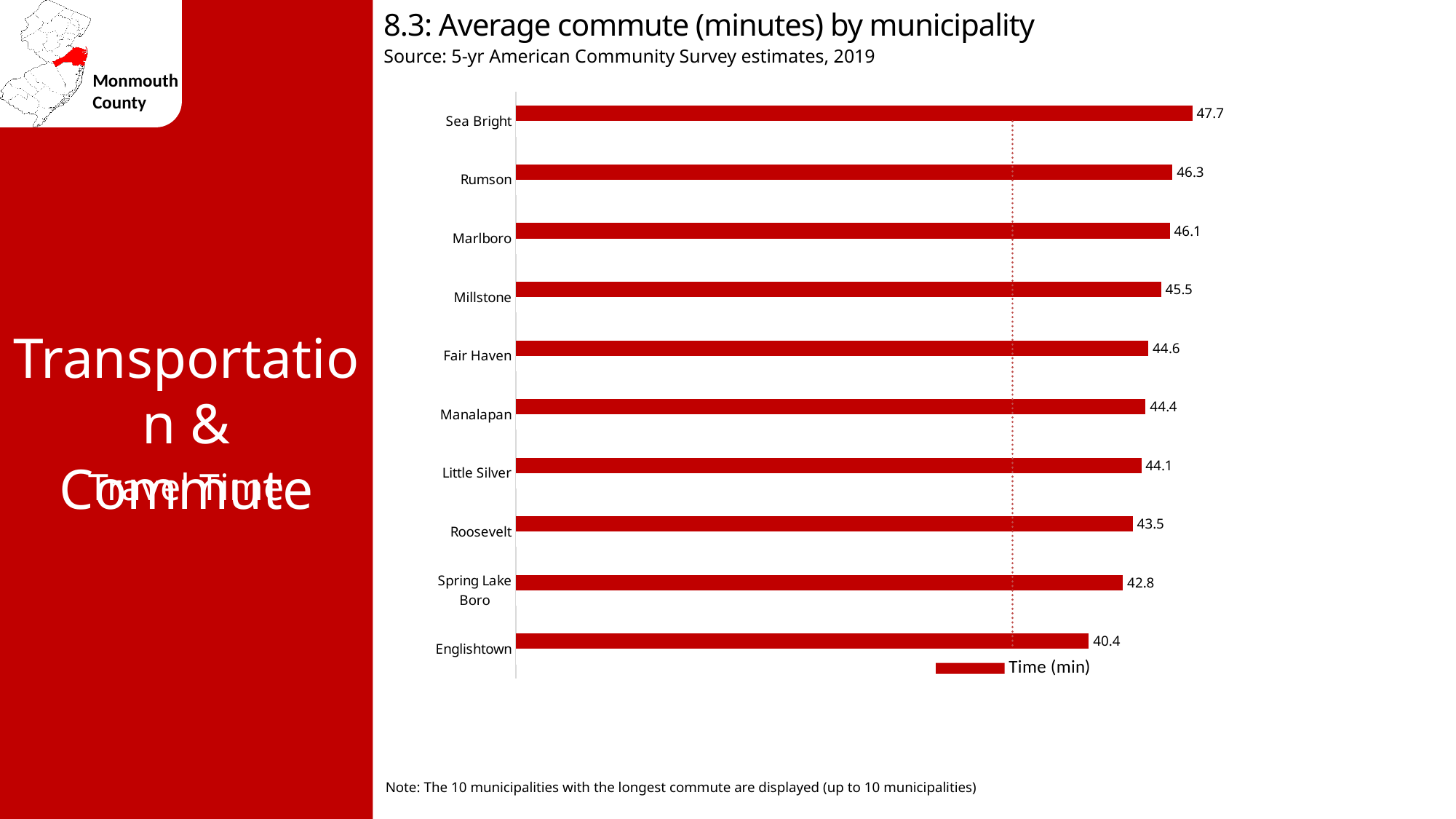
What is the difference in average commute time between Rumson and Roosevelt? 2.8 What is the legend entry for the series in the chart? Time (min) What is the difference in average commute time between Sea Bright and Englishtown? 7.3 How many series does the legend list? 1 Which municipality has the shortest average commute among those shown? Englishtown What is the average commute time for Spring Lake Boro? 42.8 Which municipality has the longest average commute? Sea Bright How many municipalities are shown in the chart? 10 What is the average commute time for Sea Bright? 47.7 What is the average commute time for Millstone? 45.5 Which has a longer average commute, Fair Haven or Little Silver? Fair Haven What kind of chart is shown on the slide? Bar chart